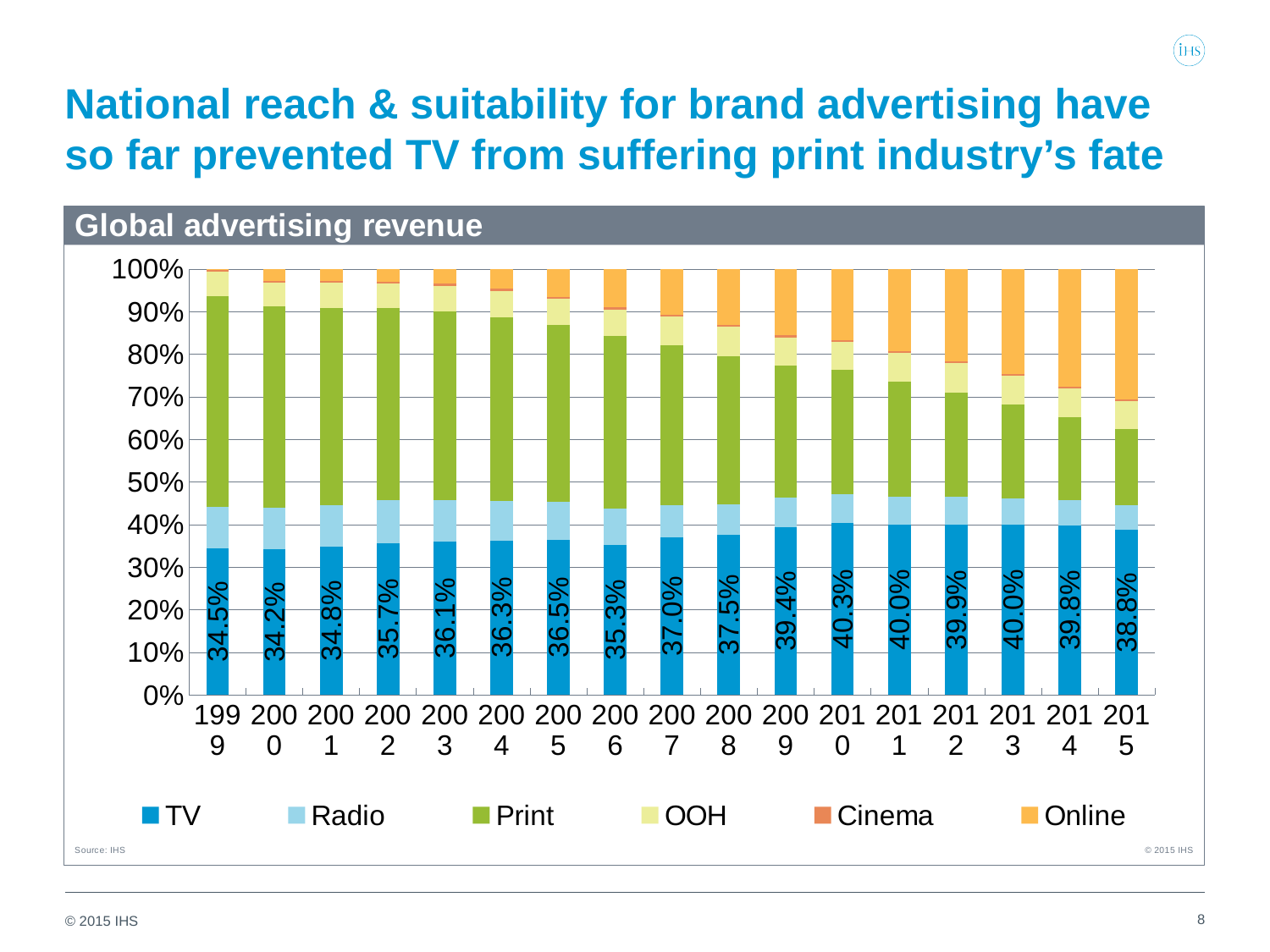
What is the TV share of global advertising revenue in 2015? 38.8% Which year has the larger TV share, 2006 or 2009? 2009 In which year is the TV share of global advertising revenue highest? 2010 What is the TV share of global advertising revenue in 2008? 37.5% How many series does the legend list? 6 By how many percentage points does the TV share in 2010 exceed the TV share in 1999? 5.8 percentage points How many years are shown on the x axis of the chart? 17 What is the TV share of global advertising revenue in 1999? 34.5% What is the title of the chart? Global advertising revenue In which year is the TV share of global advertising revenue lowest? 2000 What kind of chart is used to show global advertising revenue? Stacked bar chart Is the top of the Print segment for 2015 greater or less than 70%? less